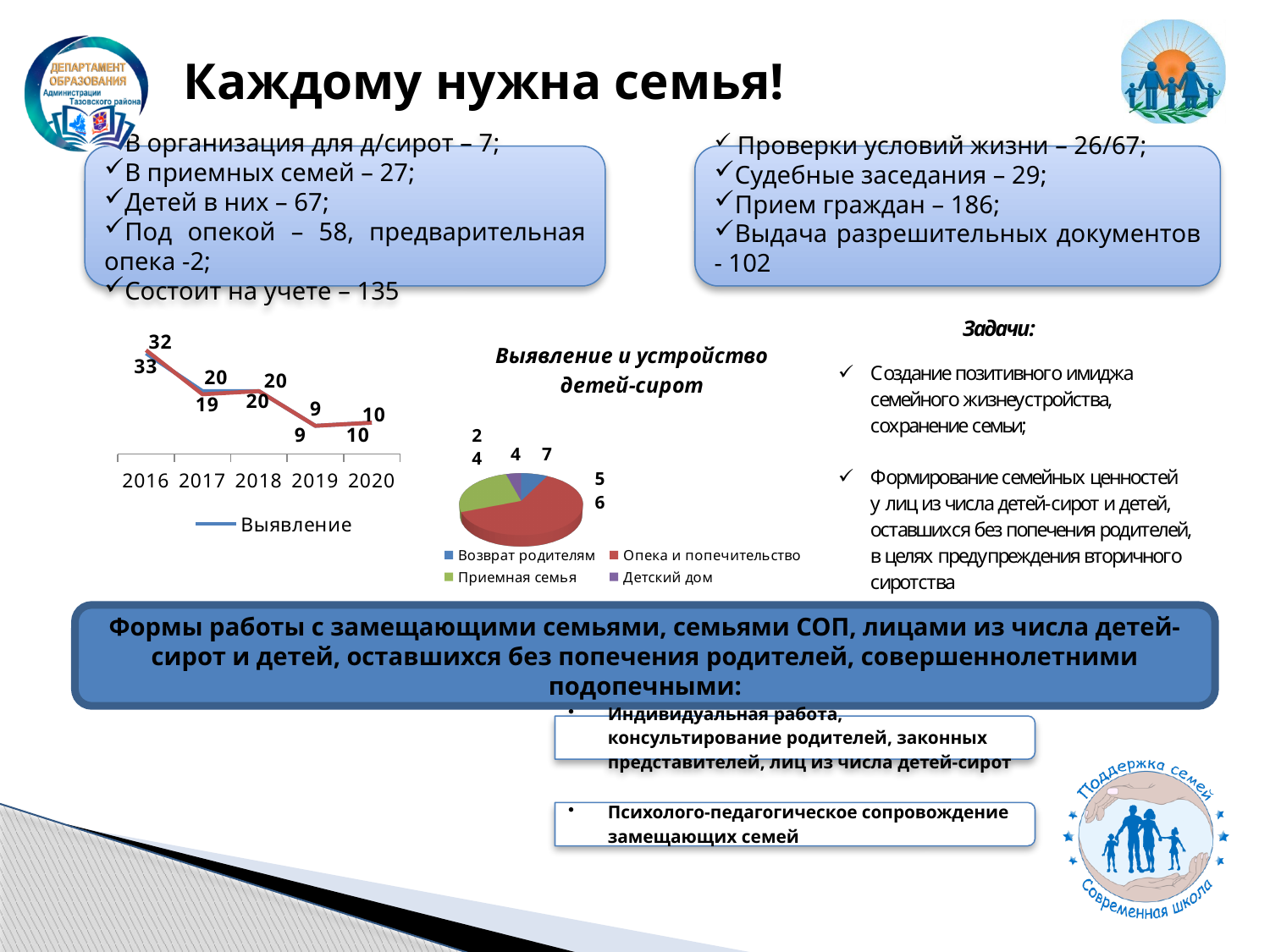
In the line chart on the left, what entry does the legend show? Выявление In the line chart on the left, what is the difference between the values for 2018 and 2019? 11 In the line chart on the left, do the values generally rise or fall from 2016 to 2020? fall In the line chart on the left, which year has the highest value? 2016 What kind of chart is the chart on the left with years 2016 to 2020 on the x axis? line chart In the line chart on the left, what is the value for 2019? 9 In the pie chart titled 'Выявление и устройство детей-сирот', how many categories does the legend list? 4 In the line chart on the left, how many years are shown on the x axis? 5 In the line chart on the left, what is the value for 2020? 10 In the line chart on the left, what is the value for 2018? 20 In the line chart on the left, which year has the lowest value? 2019 What kind of chart is the chart titled 'Выявление и устройство детей-сирот'? pie chart